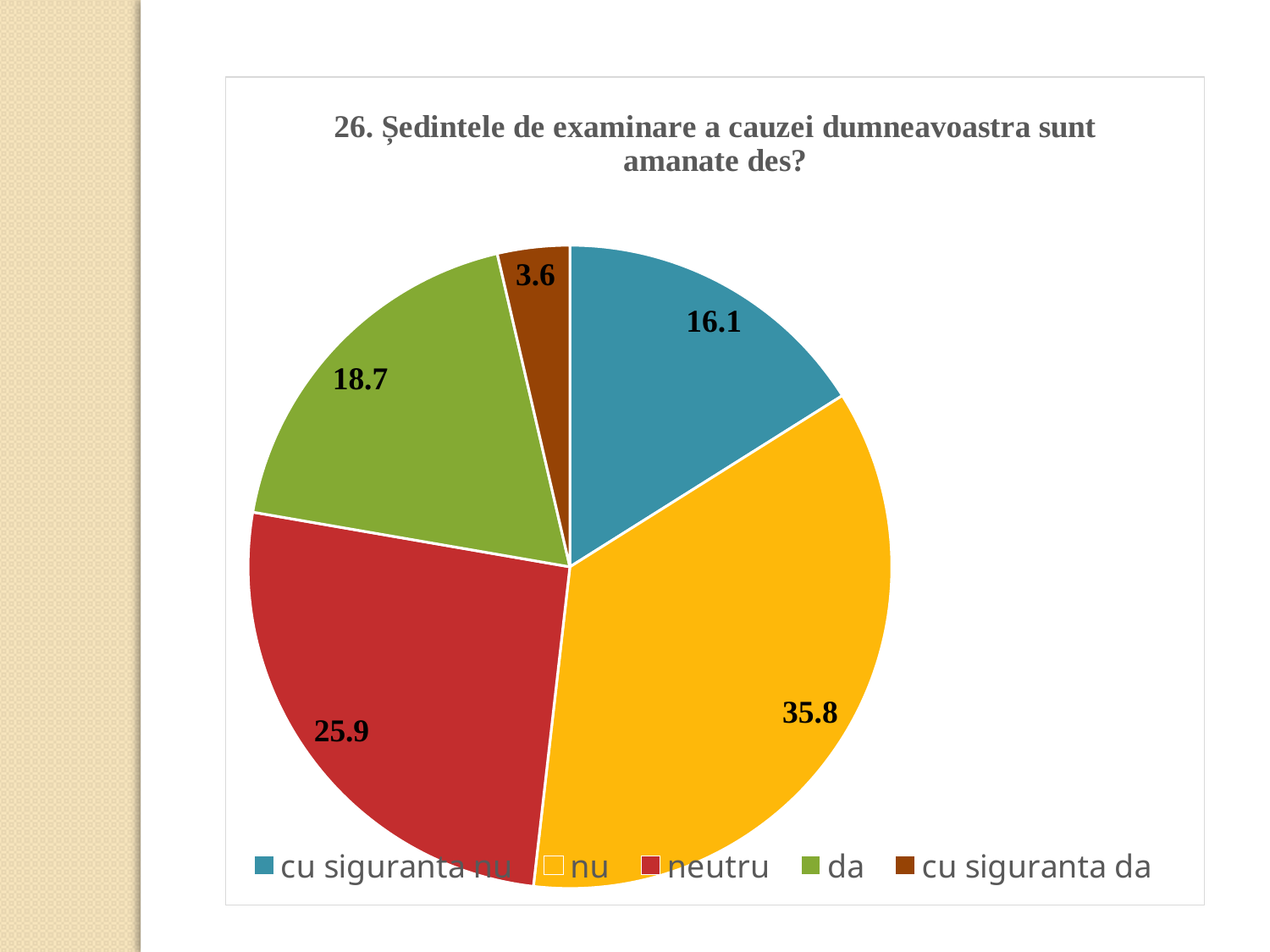
What is the value for "nu"? 35.8 What is the difference between the values for "nu" and "neutru"? 9.9 What is the value for "cu siguranta nu"? 16.1 What kind of chart is shown on the slide? pie chart Which category has the largest slice? nu What is the value for "neutru"? 25.9 Which category has the smallest slice? cu siguranta da Which is larger, the value for "da" or the value for "cu siguranta nu"? da What colour is the slice for "neutru"? red How many categories does the legend list? 5 What is the value for "da"? 18.7 What is the value for "cu siguranta da"? 3.6